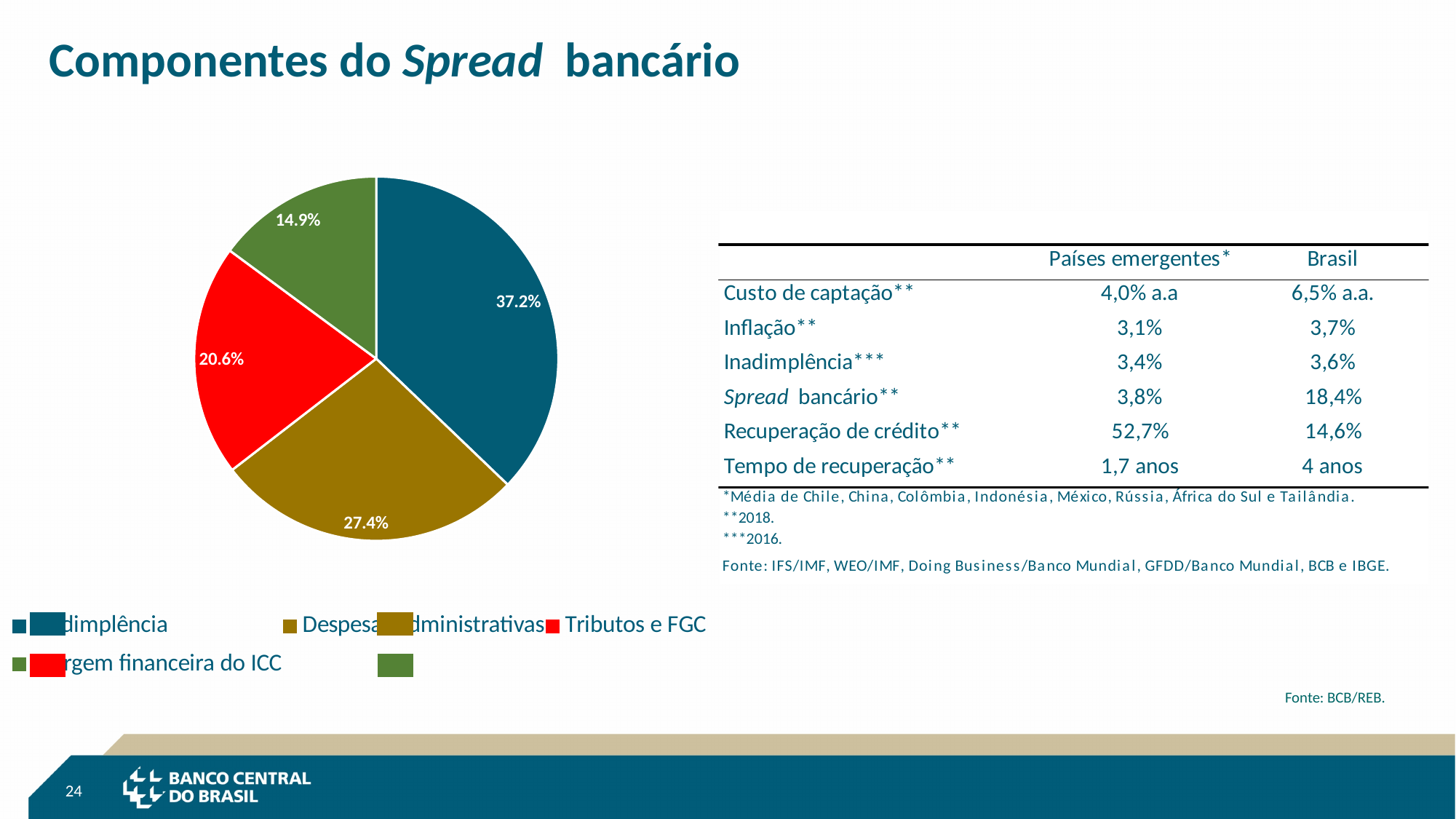
What colour is used for Tributos e FGC in the pie chart? red What is the difference between the largest slice (37.2%) and the gold slice (27.4%) in the pie chart? 9.8 percentage points How many slices does the pie chart have? 4 What value is shown on the gold (olive) slice of the pie chart? 27.4% What is the difference between the red slice (20.6%) and the green slice (14.9%) in the pie chart? 5.7 percentage points What percentage does the pie chart show for Tributos e FGC? 20.6% Which slice is larger in the pie chart, the red slice or the green slice? the red slice (20.6%) What kind of chart is shown on the slide? pie chart What is the value of the largest slice in the pie chart? 37.2% What share of the pie does Tributos e FGC represent? 20.6% What is the value of the smallest slice in the pie chart? 14.9% What is the title of the slide containing the pie chart? Componentes do Spread bancário